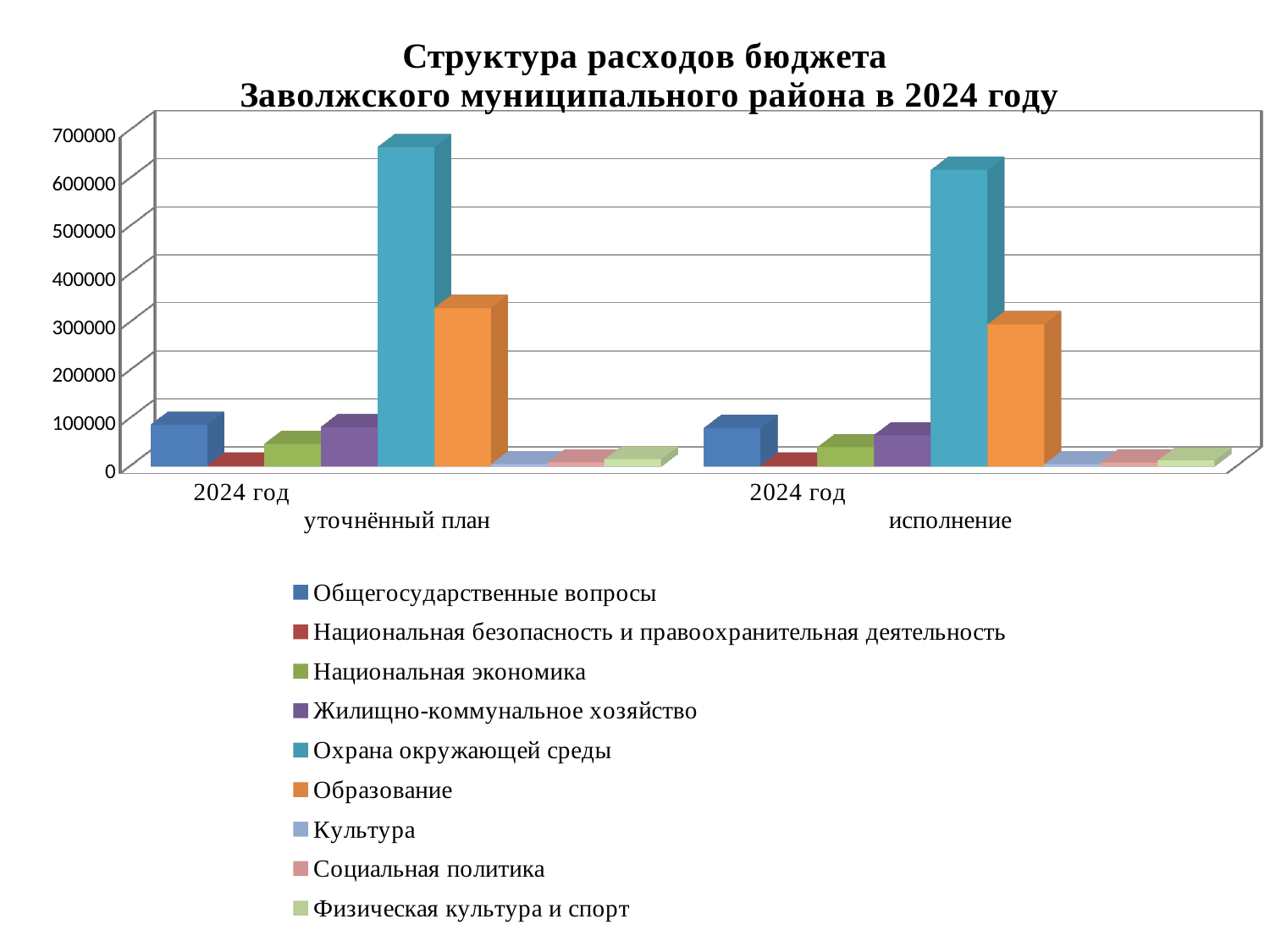
Is the value for Образование in the '2024 год исполнение' group greater or less than 400000? less Which series has the tallest bar in the '2024 год уточнённый план' group? Охрана окружающей среды What kind of chart is shown on the slide? bar chart Which series has the second tallest bar in the '2024 год уточнённый план' group? Образование What is the title of the chart? Структура расходов бюджета Заволжского муниципального района в 2024 году Which series has the tallest bar in the '2024 год исполнение' group? Охрана окружающей среды How many series does the legend list? 9 Is the value for Охрана окружающей среды in the '2024 год уточнённый план' group greater or less than 600000? greater Is the value for Охрана окружающей среды in the '2024 год исполнение' group greater or less than 500000? greater How many category groups are shown along the x axis? 2 Does the value for Охрана окружающей среды rise or fall from 'уточнённый план' to 'исполнение'? fall In the '2024 год уточнённый план' group, which is larger: Образование or Общегосударственные вопросы? Образование